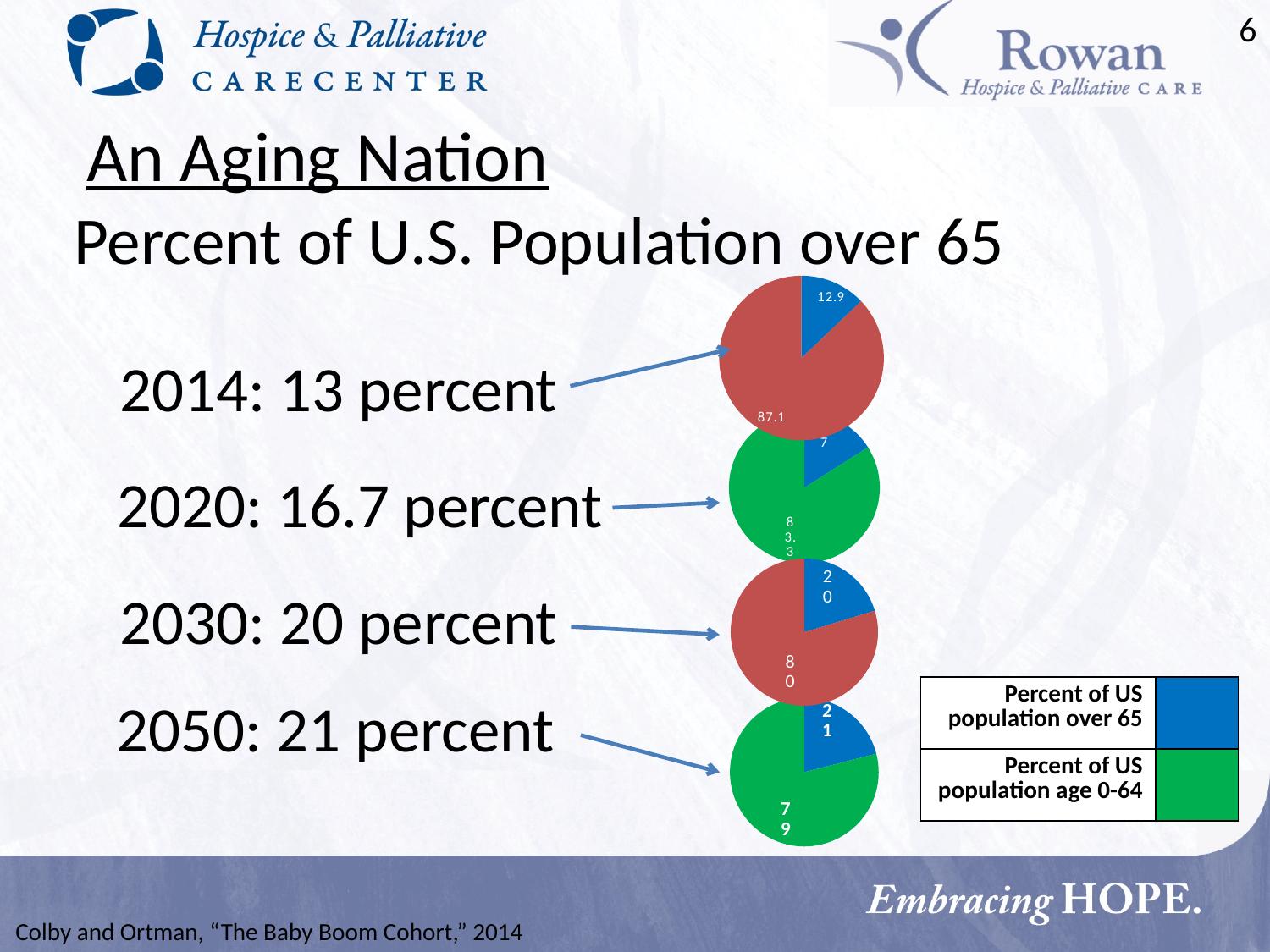
In the third pie chart from the top (2030), which slice is larger: over 65 or age 0-64? Age 0-64 In the top pie chart (2014), what is the difference between the age 0-64 slice and the over 65 slice? 74.2 How many pie charts are on the slide? 4 How many entries does the legend list? 2 In the top pie chart (2014), what value is shown for the percent of US population over 65? 12.9 In the bottom pie chart (2050), what value is shown for the percent of US population age 0-64? 79 Across the pie charts from 2014 to 2050, does the over-65 slice grow or shrink? Grows In the third pie chart from the top (2030), what value is shown for the percent of US population over 65? 20 Which colour represents the percent of US population over 65 in the legend? Blue In the bottom pie chart (2050), what value is shown for the percent of US population over 65? 21 What kind of charts are shown on the slide? Pie charts In the top pie chart (2014), what value is shown for the percent of US population age 0-64? 87.1